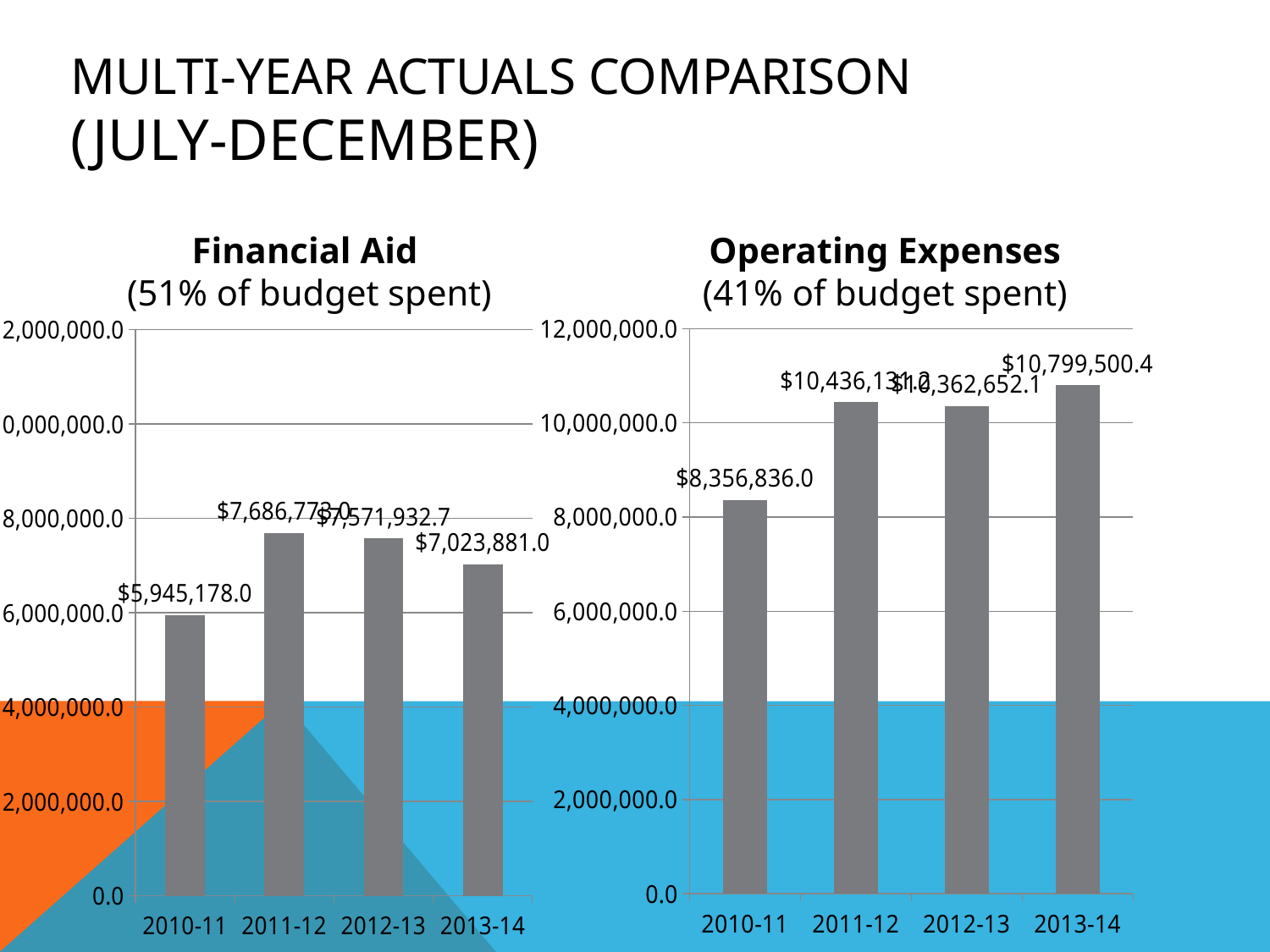
How many years are shown on the x axis of the Operating Expenses chart? 4 In the Financial Aid chart, what is the difference between the 2012-13 value and the 2013-14 value? $548,051.7 In the Financial Aid chart, what is the value for 2013-14? $7,023,881.0 In the Operating Expenses chart, which year has the lowest value? 2010-11 In the Operating Expenses chart, which year has the highest value? 2013-14 In the Operating Expenses chart, what is the value for 2010-11? $8,356,836.0 In the Financial Aid chart, which is larger, the value for 2012-13 or the value for 2013-14? 2012-13 In the Operating Expenses chart, what is the value for 2013-14? $10,799,500.4 In the Financial Aid chart, what is the value for 2010-11? $5,945,178.0 In the Financial Aid chart, which year has the lowest value? 2010-11 In the Operating Expenses chart, how much larger is the 2013-14 value than the 2010-11 value? $2,442,664.4 What kind of chart is the Financial Aid chart? Bar chart